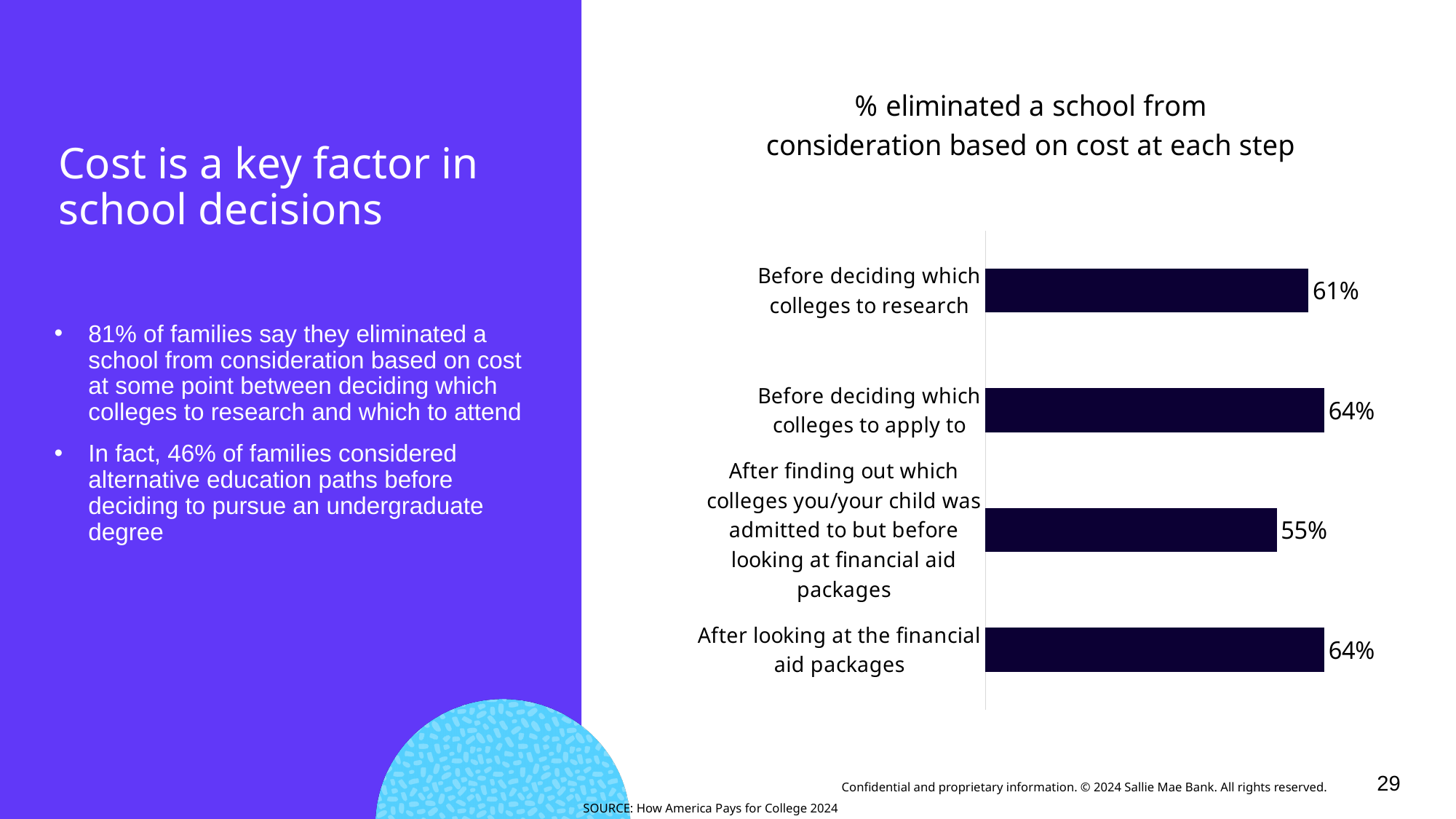
What is the title of the chart? % eliminated a school from consideration based on cost at each step What type of chart is shown on the slide? Bar chart What percentage eliminated a school from consideration based on cost after looking at the financial aid packages? 64% What percentage eliminated a school from consideration based on cost before deciding which colleges to research? 61% Which two steps share the same percentage value in the chart? Before deciding which colleges to apply to and After looking at the financial aid packages What is the difference between the percentage before deciding which colleges to apply to and the percentage after finding out which colleges they were admitted to but before looking at financial aid packages? 9% How many steps (categories) are shown in the chart? 4 What percentage eliminated a school from consideration based on cost after finding out which colleges they were admitted to but before looking at financial aid packages? 55% What percentage eliminated a school from consideration based on cost before deciding which colleges to apply to? 64% Which is larger: the percentage before deciding which colleges to research or the percentage after looking at the financial aid packages? After looking at the financial aid packages Which step has the lowest percentage of families eliminating a school based on cost? After finding out which colleges you/your child was admitted to but before looking at financial aid packages What is the difference between the percentage before deciding which colleges to apply to and the percentage before deciding which colleges to research? 3%